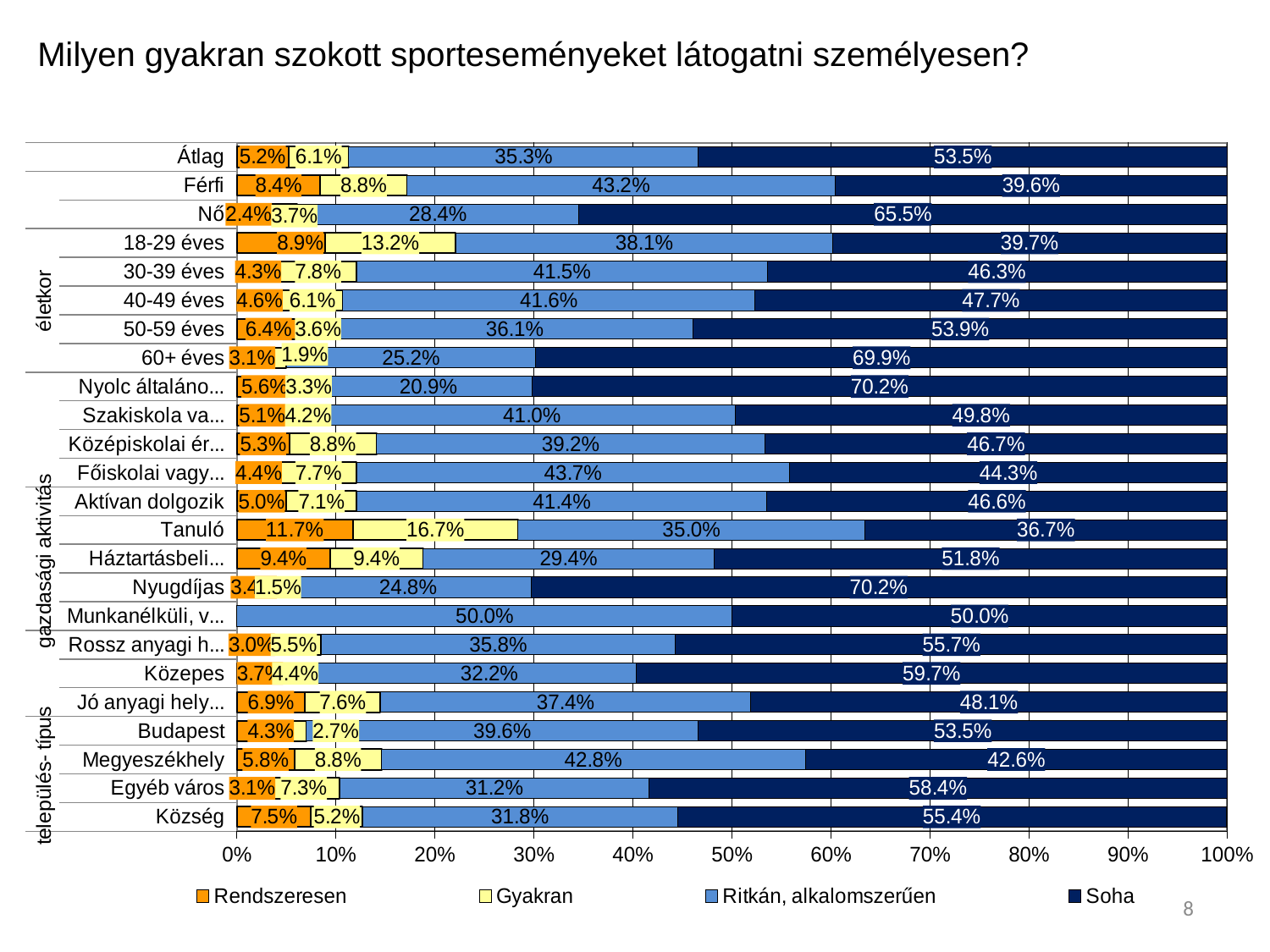
How many series does the legend list? 4 What is the 'Soha' value for Átlag? 53.5% What is the 'Gyakran' value for Tanuló? 16.7% How many categories are shown on the chart? 24 What is the 'Soha' value for 60+ éves? 69.9% What is the difference between the 'Soha' values for Nő and Férfi? 25.9 percentage points Which category has the highest 'Rendszeresen' value? Tanuló What is the title of the chart? Milyen gyakran szokott sporteseményeket látogatni személyesen? Which has a larger 'Soha' value, Budapest or Megyeszékhely? Budapest What kind of chart is shown on the slide? Stacked bar chart What is the 'Ritkán, alkalomszerűen' value for Férfi? 43.2% Which category has the lowest 'Soha' value? Tanuló